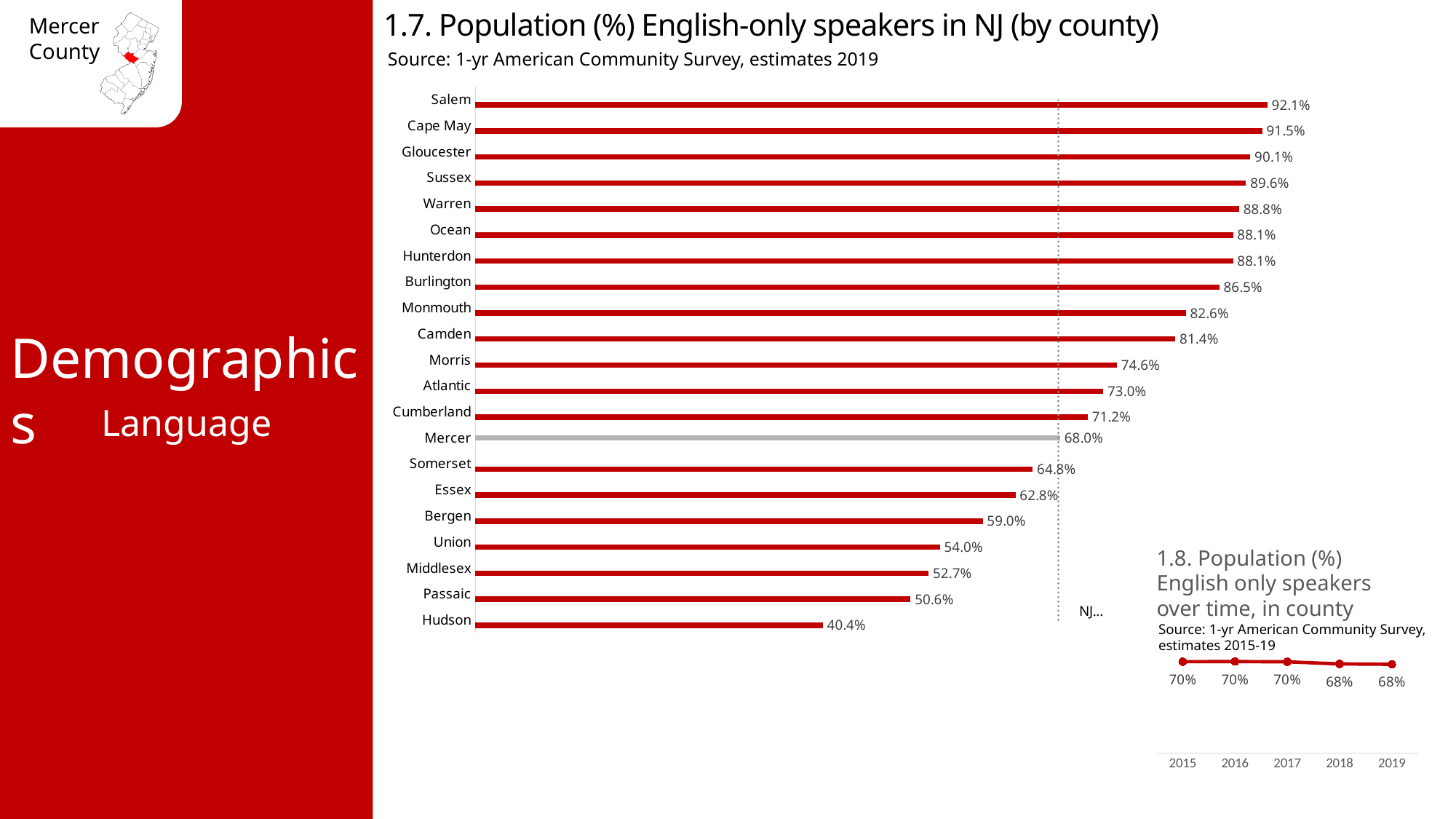
What kind of chart is chart 1.7? Bar chart In chart 1.7, which county has the highest percentage of English-only speakers? Salem In chart 1.8, do the values rise or fall from 2015 to 2019? Fall In chart 1.7, which county has the lowest percentage of English-only speakers? Hudson In chart 1.8, how many years are plotted? 5 In chart 1.7, which is larger, the value for Morris or the value for Atlantic? Morris In chart 1.7, what is the value for Mercer? 68.0% In chart 1.7, how many counties are plotted? 21 In chart 1.7, what is the difference between the values for Mercer and Somerset? 3.2% In chart 1.7, what is the difference between the values for Salem and Hudson? 51.7% In chart 1.7, what is the value for Hudson? 40.4% In chart 1.8, what is the value for 2019? 68%